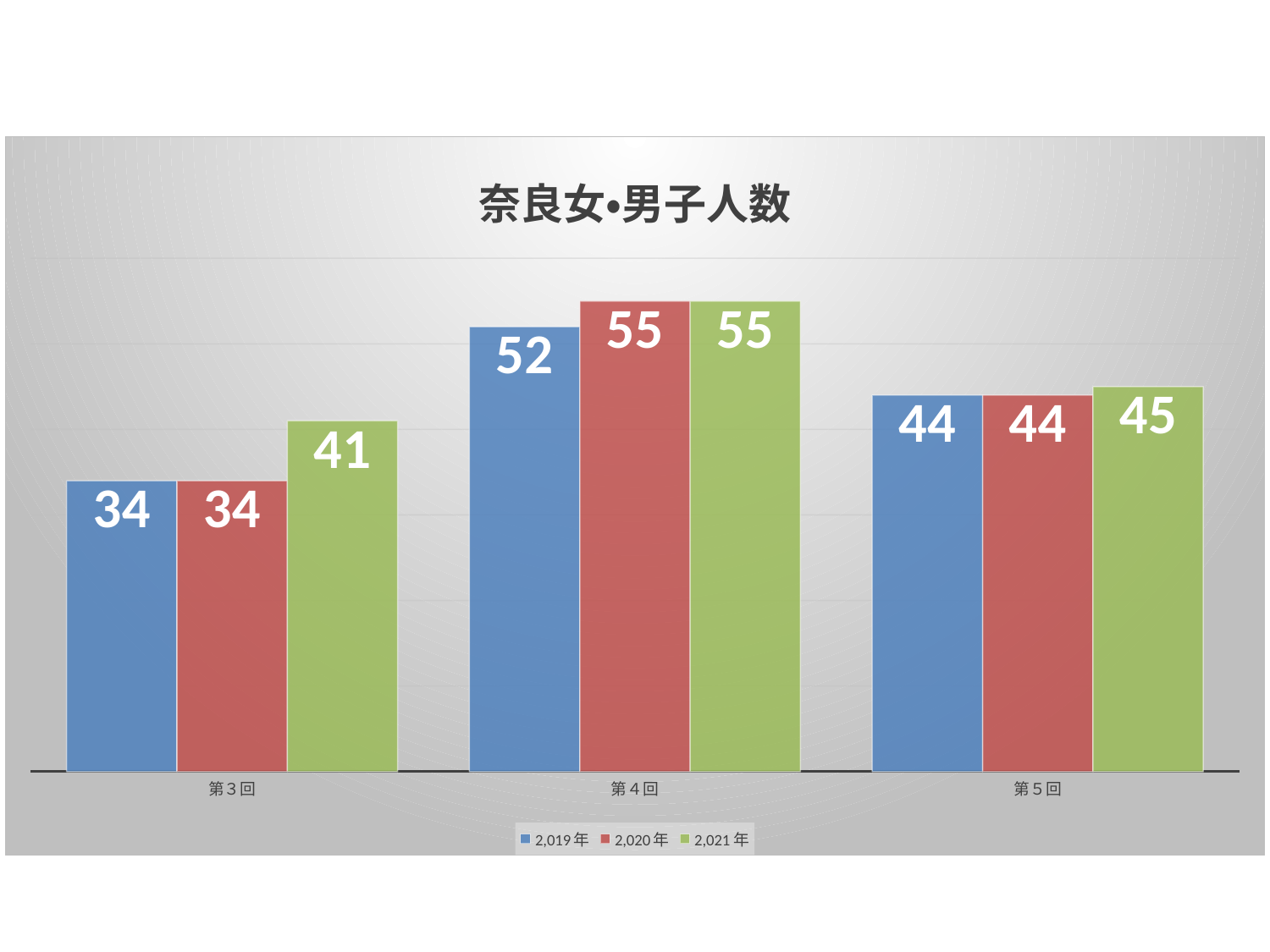
What is the difference between the 2,021 年 and 2,019 年 values for 第3回? 7 Which category has the lowest value in the 2,019 年 series? 第3回 What is the difference between the 2,020 年 and 2,019 年 values for 第4回? 3 Which is larger for 第5回: the 2,021 年 value or the 2,019 年 value? 2,021 年 What is the value for 第5回 in the 2,020 年 series? 44 How many categories are shown on the x axis? 3 What is the value for 第3回 in the 2,021 年 series? 41 Which category has the highest value in the 2,021 年 series? 第4回 How many series does the legend list? 3 What kind of chart is shown on the slide? bar chart What is the value for 第4回 in the 2,019 年 series? 52 What is the title of the chart? 奈良女•男子人数